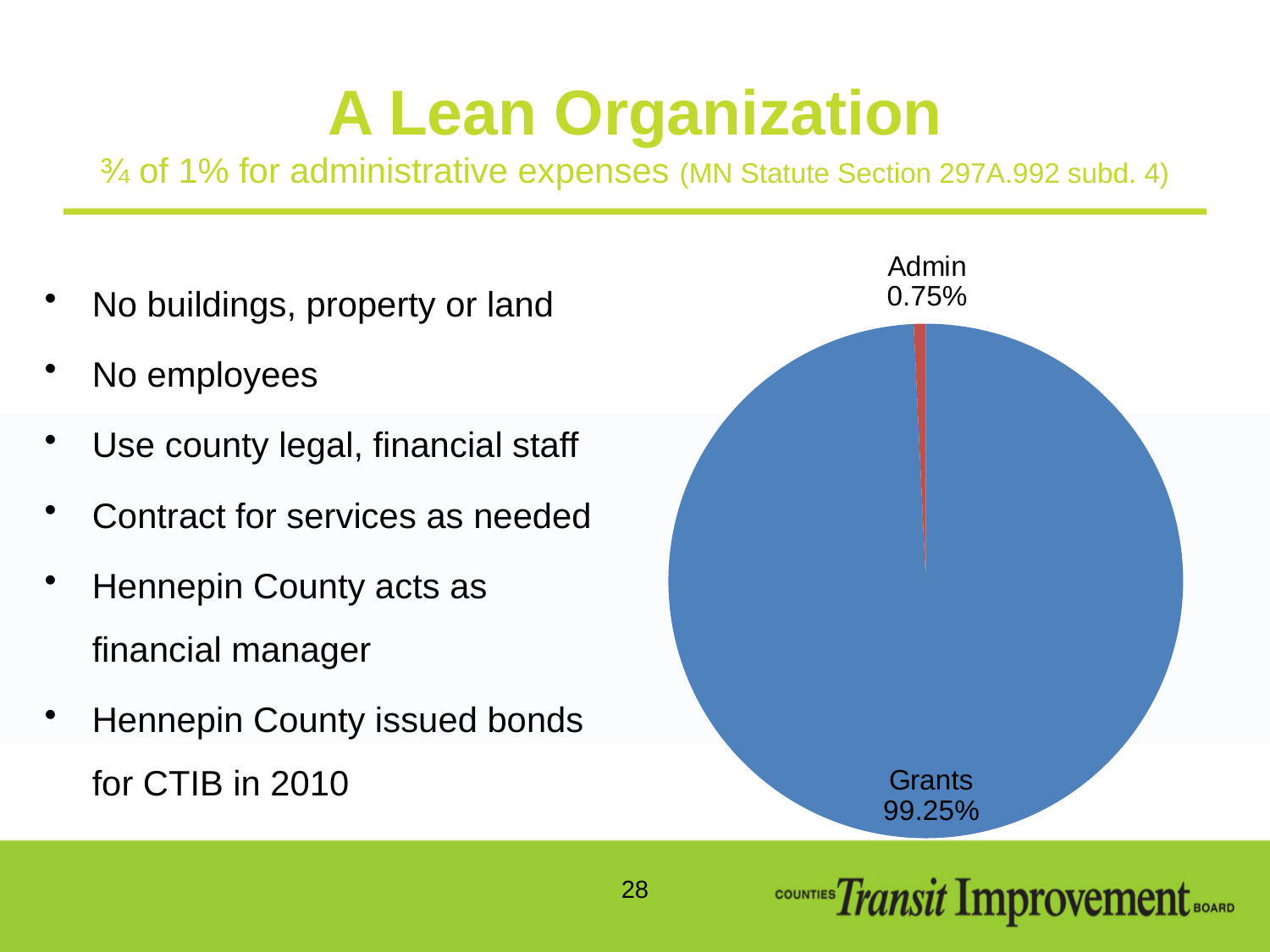
What share of the pie does Admin represent? 0.75% Which is larger, the Grants slice or the Admin slice? Grants What colour is the Admin slice of the pie? red How many slices does the pie chart have? 2 What colour is the Grants slice of the pie? blue What is the difference in percentage points between the Grants slice and the Admin slice? 98.5 What kind of chart is shown on the slide? pie chart Which slice of the pie is the largest? Grants What share of the pie does Grants represent? 99.25% Which slice of the pie is the smallest? Admin